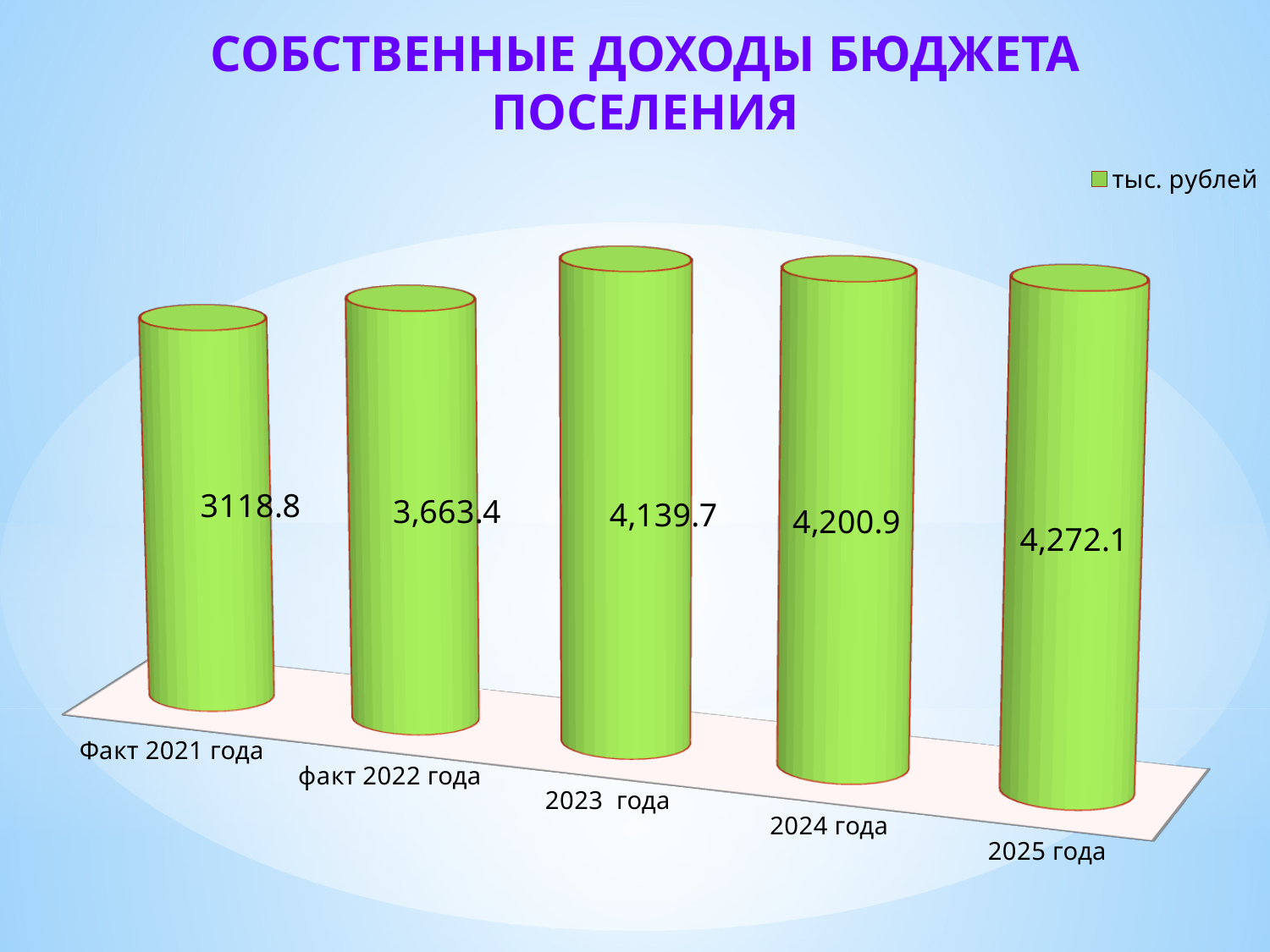
What is the value for 2023 года? 4,139.7 Which category has the lowest value? Факт 2021 года Which is larger, the value for 2024 года or the value for 2023 года? 2024 года What is the value for факт 2022 года? 3,663.4 What is the value for Факт 2021 года? 3118.8 What is the value for 2025 года? 4,272.1 What is the value for 2024 года? 4,200.9 Do the values rise or fall from Факт 2021 года to 2025 года? rise What is the difference between the values for факт 2022 года and Факт 2021 года? 544.6 How many categories are shown on the chart? 5 Which category has the highest value according to the data labels? 2025 года What is the difference between the values for 2025 года and Факт 2021 года? 1,153.3